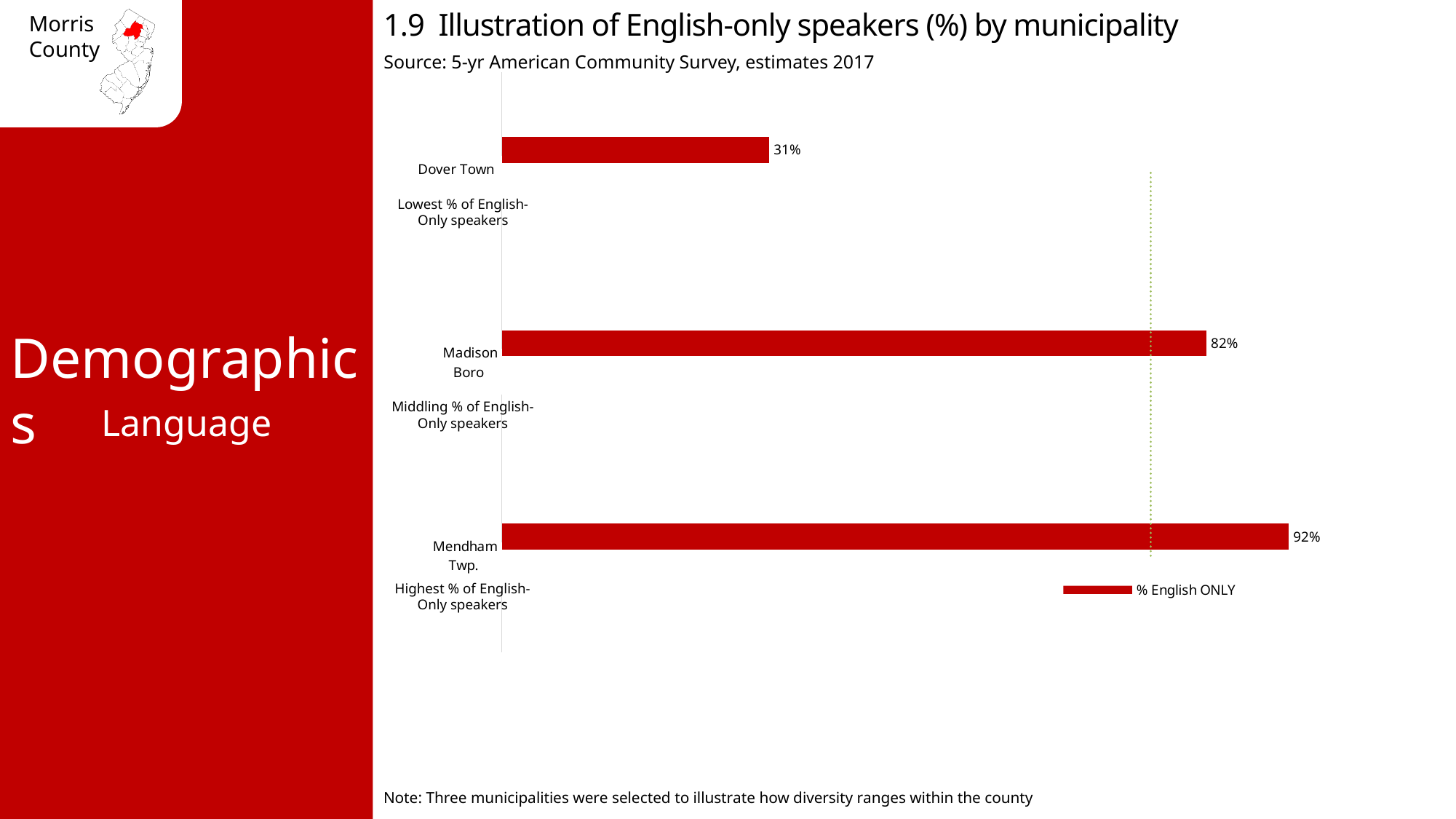
What kind of chart is shown on the slide? Bar chart What is the percentage of English-only speakers in Madison Boro? 82% What is the difference in percentage points between Mendham Twp. and Dover Town? 61 How many series does the legend list? 1 How many municipalities are shown in the chart? 3 What is the difference in percentage points between Mendham Twp. and Madison Boro? 10 Which has a higher percentage of English-only speakers, Madison Boro or Dover Town? Madison Boro What is the percentage of English-only speakers in Mendham Twp.? 92% Which municipality has the lowest percentage of English-only speakers? Dover Town Which municipality has the highest percentage of English-only speakers? Mendham Twp. What is the name of the series shown in the legend? % English ONLY What is the percentage of English-only speakers in Dover Town? 31%